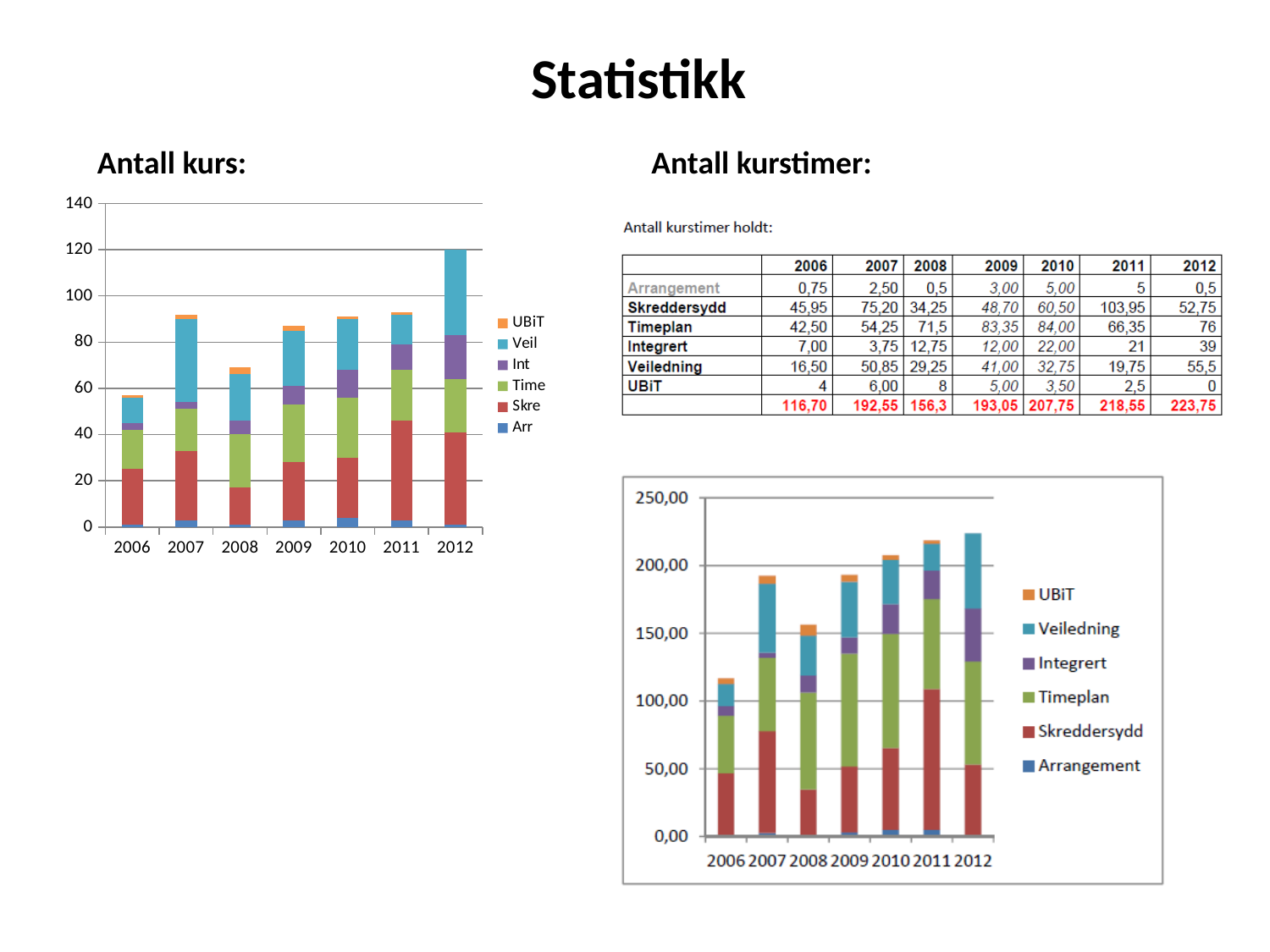
In the 'Antall kurs' chart, is the total for 2012 greater or less than 100? greater What kind of chart is the 'Antall kurs' chart? stacked bar chart In the 'Antall kurstimer' chart, which year has the lowest total? 2006 In the 'Antall kurs' chart, is the total for 2008 greater or less than 80? less In the 'Antall kurstimer' chart, how many years are shown on the x axis? 7 In the 'Antall kurstimer' chart, which is larger, the total for 2007 or the total for 2008? 2007 In the 'Antall kurstimer' chart, what is the total number of course hours for 2012? 223,75 In the 'Antall kurs' chart, which year has the shortest stacked bar? 2006 In the 'Antall kurs' chart, how many series does the legend list? 6 In the 'Antall kurs' chart, which year has the tallest stacked bar? 2012 In the 'Antall kurstimer' chart, what is the Skreddersydd value for 2011? 103,95 In the 'Antall kurstimer' chart, which series is shown in green in the legend? Timeplan